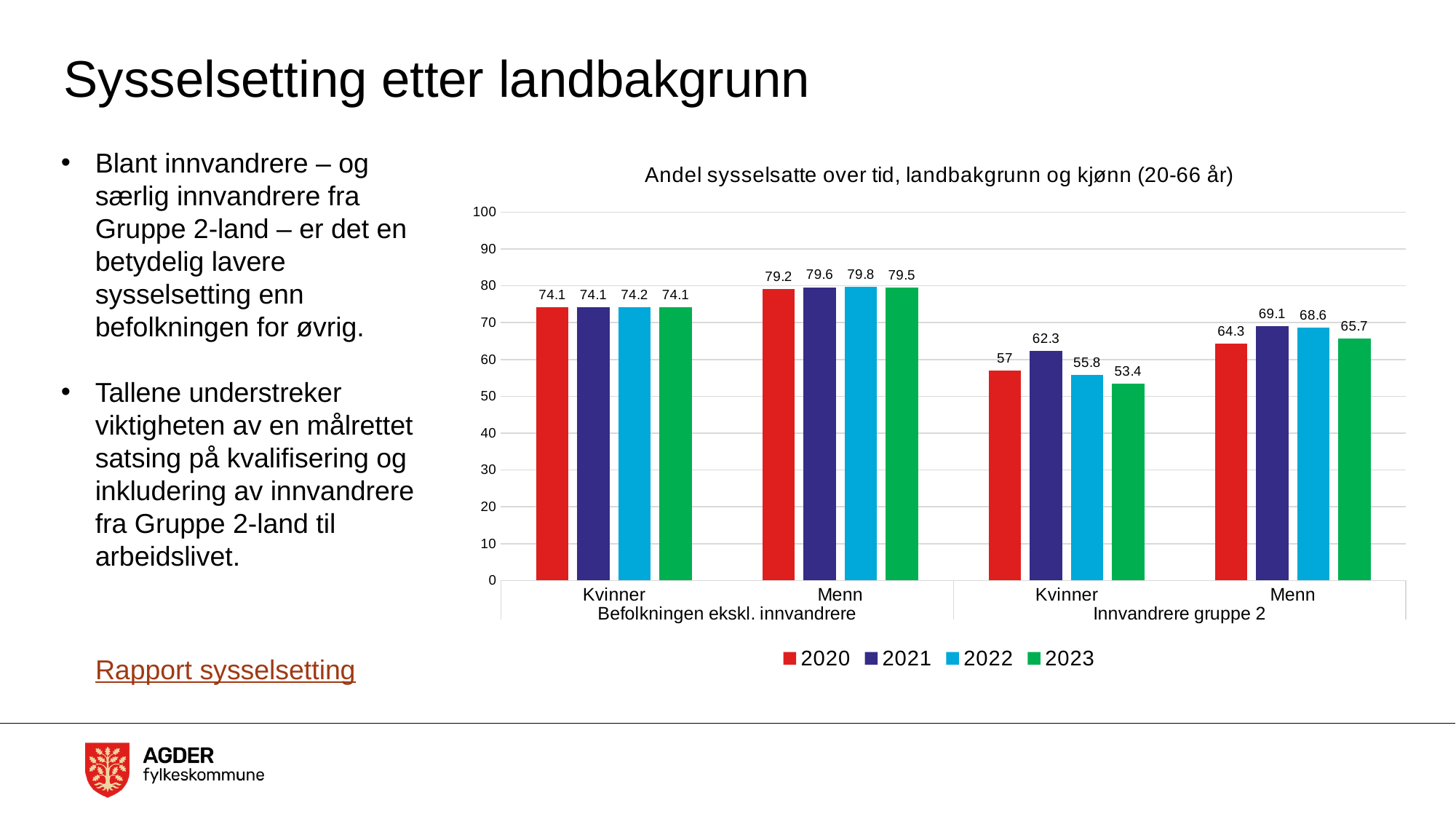
What is the difference between the 2023 values for Menn in Befolkningen ekskl. innvandrere and Menn in Innvandrere gruppe 2? 13.8 What kind of chart is shown on the slide? Bar chart Which colour represents 2023 in the chart? Green Which year has the highest value for Menn in Innvandrere gruppe 2? 2021 Which year has the lowest value for Kvinner in Innvandrere gruppe 2? 2023 What is the value for Menn in Befolkningen ekskl. innvandrere in 2022? 79.8 What is the value for Kvinner in Innvandrere gruppe 2 in 2021? 62.3 What is the value for Menn in Innvandrere gruppe 2 in 2023? 65.7 How many category groups are shown on the x axis? 4 What is the title of the chart? Andel sysselsatte over tid, landbakgrunn og kjønn (20-66 år) How many series does the legend list? 4 Which is larger: the 2020 value for Kvinner in Innvandrere gruppe 2 or the 2020 value for Menn in Innvandrere gruppe 2? Menn in Innvandrere gruppe 2